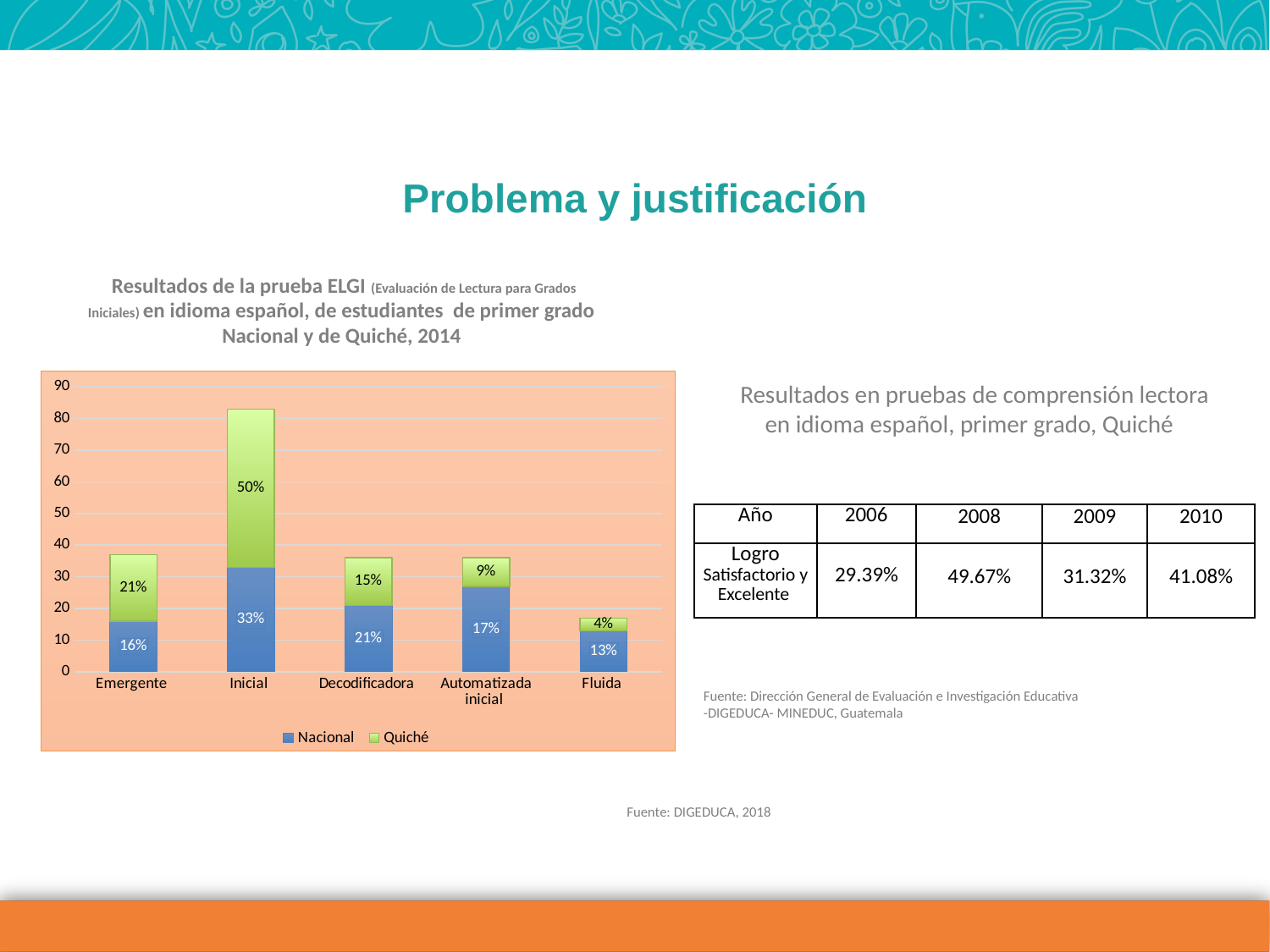
What is the Nacional value for the Inicial category? 33% How many categories are shown on the x axis of the chart? 5 What is the total of the stacked bar for the Inicial category? 83% Which colour represents the Quiché series in the chart? Green What is the Quiché value for the Fluida category? 4% What kind of chart is shown on the slide? Stacked bar chart For the Decodificadora category, which series has the larger value, Nacional or Quiché? Nacional Which category has the highest Quiché value? Inicial For the Inicial category, how much larger is the Quiché value than the Nacional value? 17% How many series does the chart's legend list? 2 What is the Quiché value for the Emergente category? 21% Which category has the lowest Quiché value? Fluida